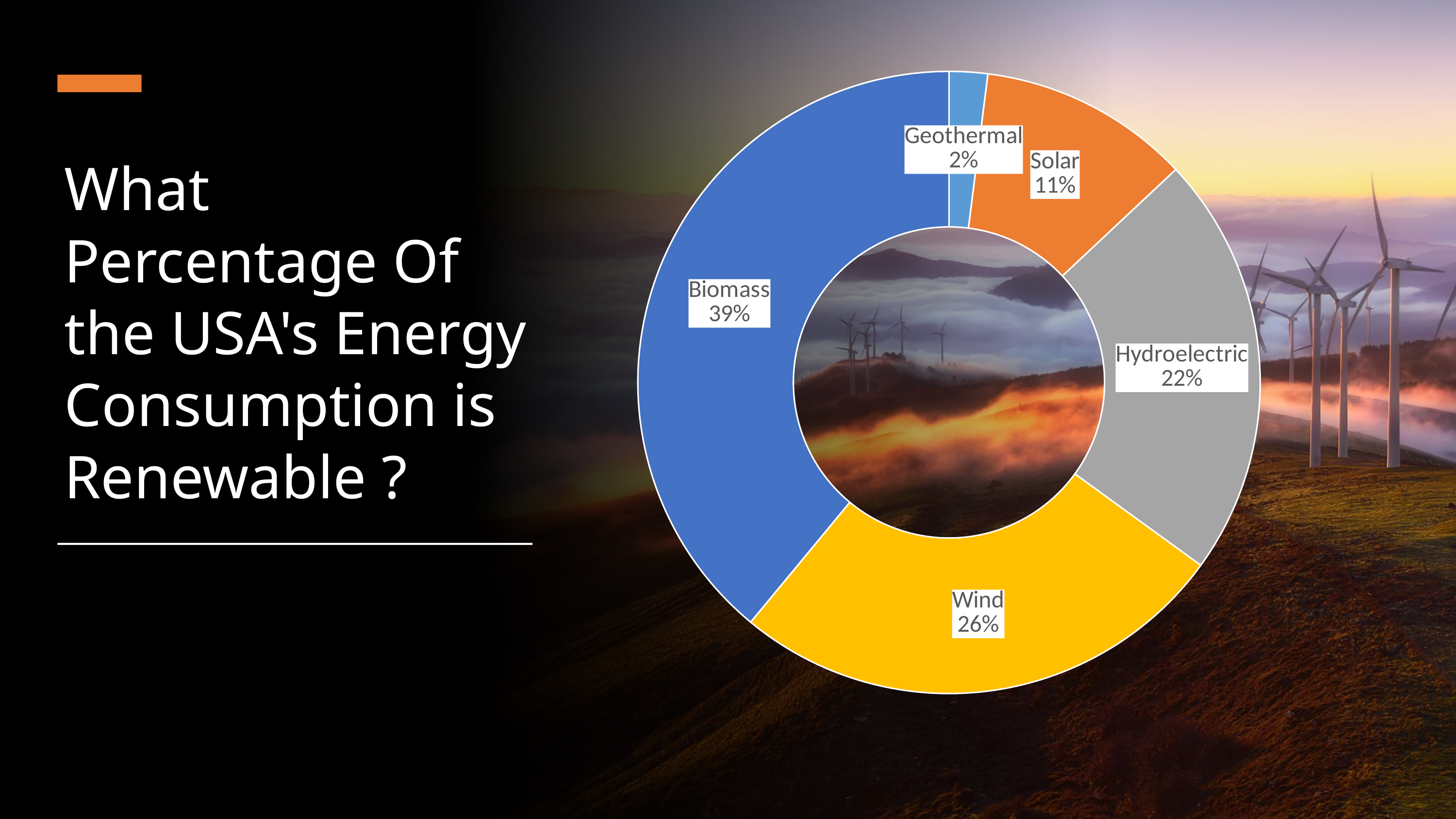
Which is larger, Wind or Hydroelectric? Wind What colour is the Wind slice? Yellow How many categories are shown in the chart? 5 What is the difference in percentage points between Hydroelectric and Solar? 11 What is the difference in percentage points between Biomass and Wind? 13 What kind of chart is shown on the slide? Doughnut chart Which category has the smallest share of the chart? Geothermal What percentage does the Solar slice show? 11% What percentage does the Hydroelectric slice show? 22% What percentage does the Geothermal slice show? 2% What percentage does the Biomass slice show? 39% Which category has the largest share of the chart? Biomass